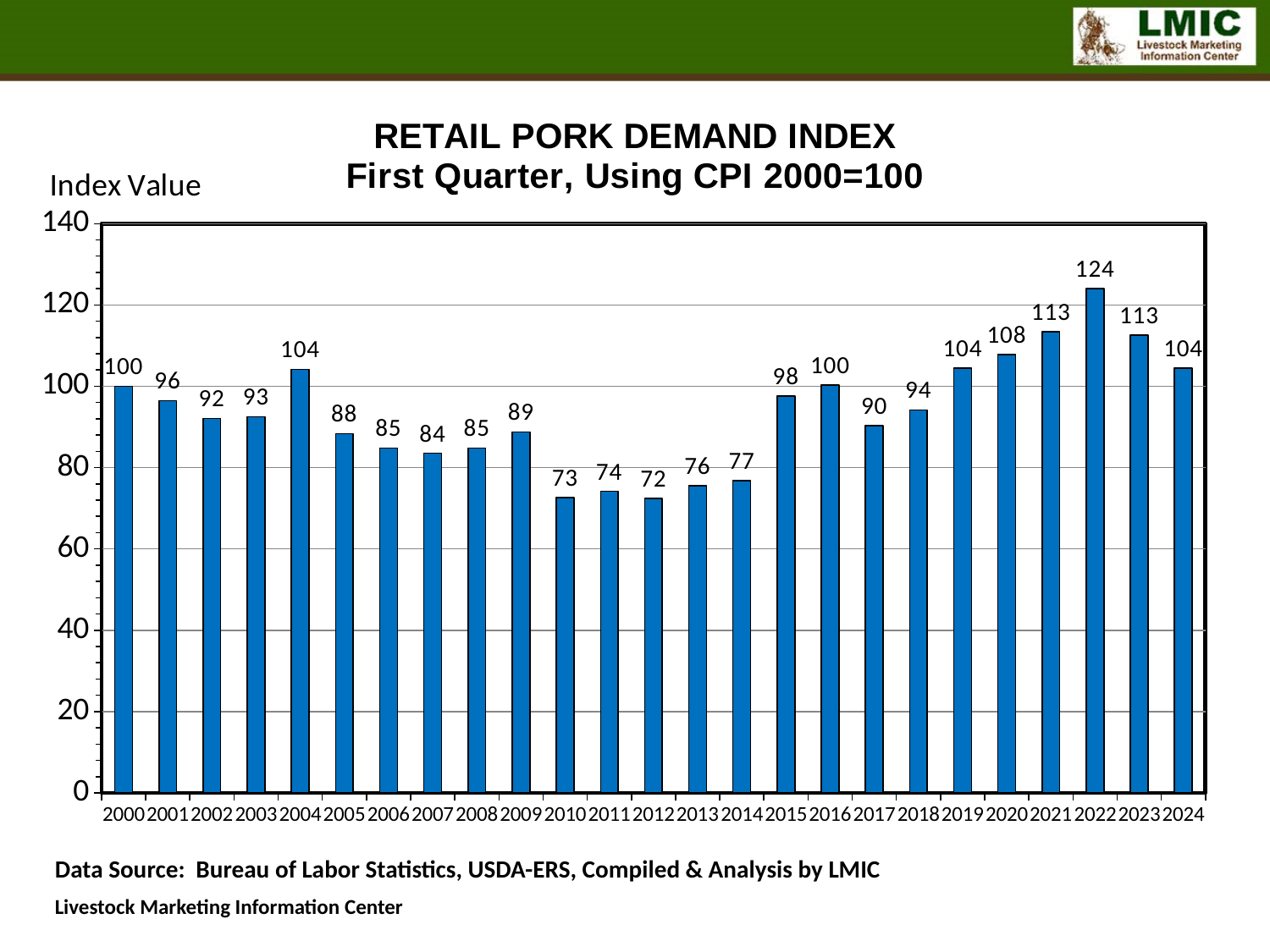
Which year has a higher index value, 2015 or 2017? 2015 Which year has the highest index value? 2022 What kind of chart is shown on the slide? bar chart Is the index value for 2010 greater or less than 80? less What is the index value shown for 2024? 104 What is the Retail Pork Demand Index value for 2022? 124 What is the label on the y axis of the chart? Index Value What is the index value shown for 2012? 72 Which year has the lowest index value? 2012 How many years are shown on the x axis? 25 What is the difference between the index values for 2004 and 2005? 16 What is the difference between the index values for 2022 and 2012? 52